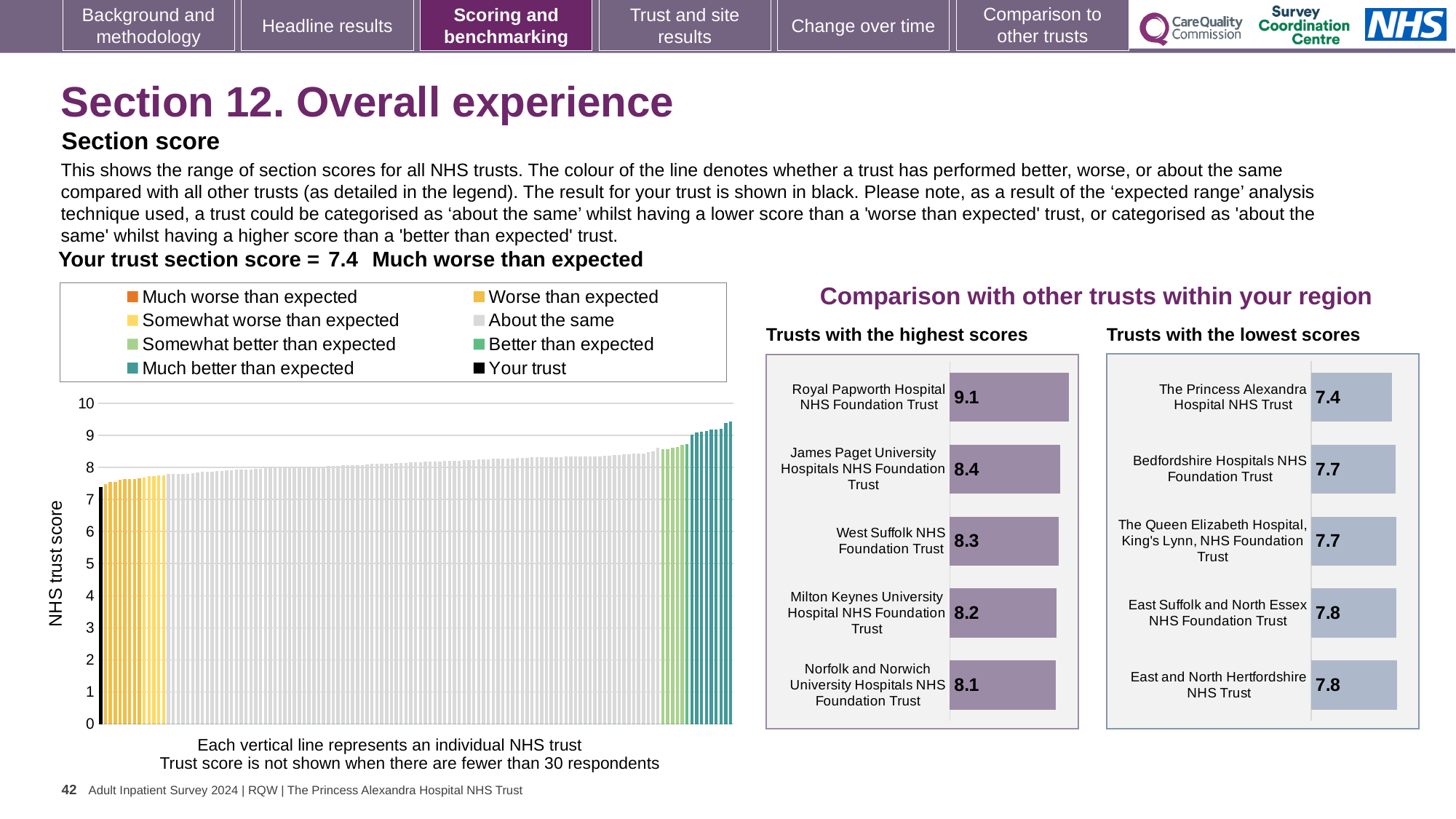
In the 'Trusts with the highest scores' chart, what is the score for West Suffolk NHS Foundation Trust? 8.3 In the 'Trusts with the lowest scores' chart, what is the score for East Suffolk and North Essex NHS Foundation Trust? 7.8 In the 'Trusts with the lowest scores' chart, how many trusts are listed? 5 What kind of chart is the large chart on the left showing NHS trust scores? bar chart In the 'Trusts with the lowest scores' chart, which trust has the lowest score? The Princess Alexandra Hospital NHS Trust In the 'Trusts with the highest scores' chart, what is the difference between the scores of Royal Papworth Hospital NHS Foundation Trust and James Paget University Hospitals NHS Foundation Trust? 0.7 In the large chart on the left, do the NHS trust scores rise or fall from left to right along the x axis? rise How many entries does the legend of the large chart on the left list? 8 In the 'Trusts with the lowest scores' chart, what is the score for The Princess Alexandra Hospital NHS Trust? 7.4 In the 'Trusts with the highest scores' chart, is the score for Milton Keynes University Hospital NHS Foundation Trust larger or smaller than the score for Norfolk and Norwich University Hospitals NHS Foundation Trust? larger In the 'Trusts with the highest scores' chart, which trust has the lowest score shown? Norfolk and Norwich University Hospitals NHS Foundation Trust In the 'Trusts with the highest scores' chart, what is the score for Royal Papworth Hospital NHS Foundation Trust? 9.1